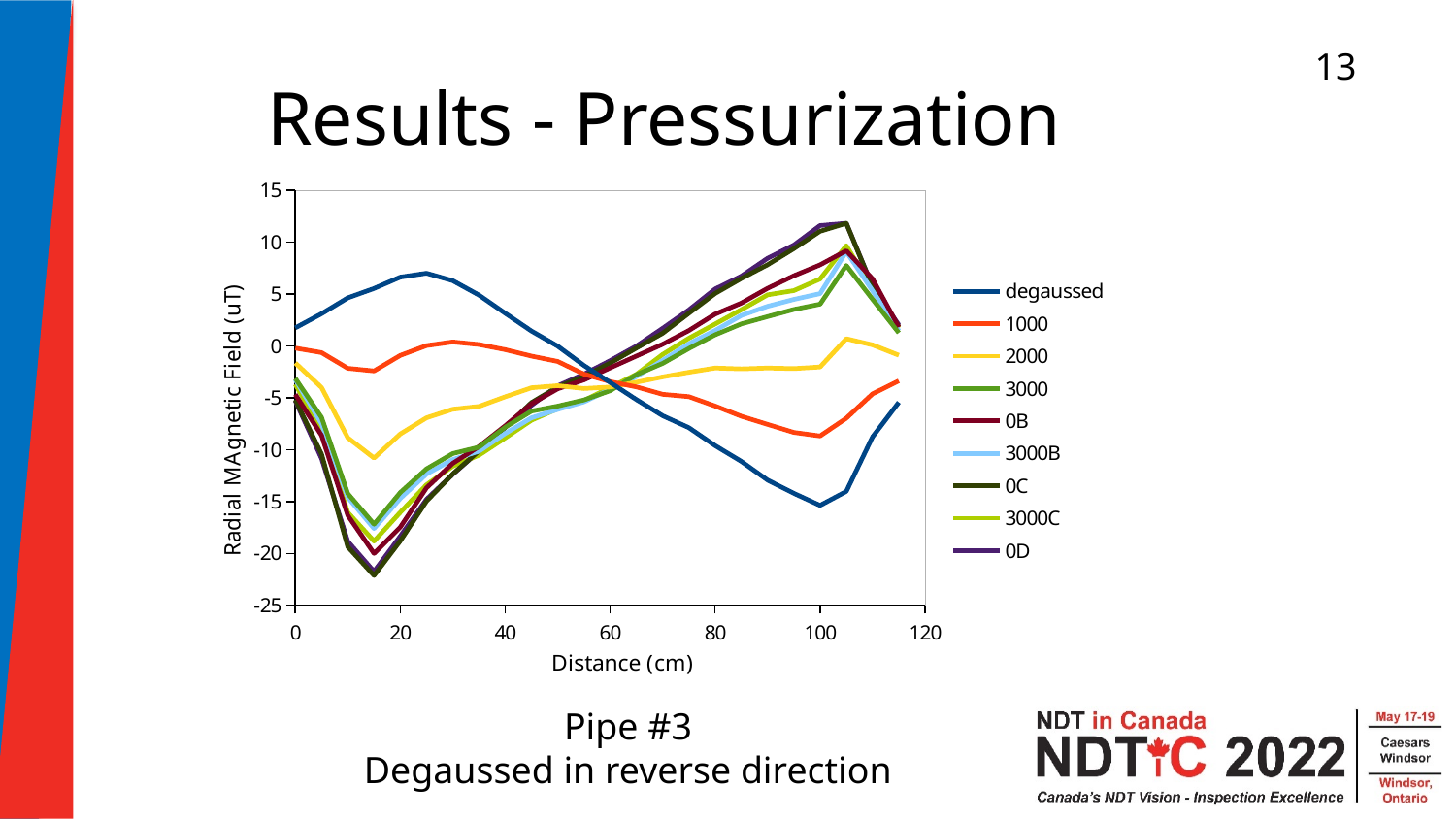
Is the value of the 0C series at a distance of 105 cm greater or less than 10? greater What is the label of the x axis? Distance (cm) At a distance of 100 cm, which series has the larger value, degaussed or 0C? 0C What kind of chart is shown on the slide? line chart Is the value of the degaussed series at a distance of 25 cm greater or less than 5? greater Is the value of the degaussed series at a distance of 100 cm greater or less than -10? less What is the label of the y axis? Radial MAgnetic Field (uT) Does the degaussed series rise or fall between 25 cm and 100 cm? fall How many series does the legend list? 9 At a distance of 15 cm, which series has the larger value, 2000 or 0C? 2000